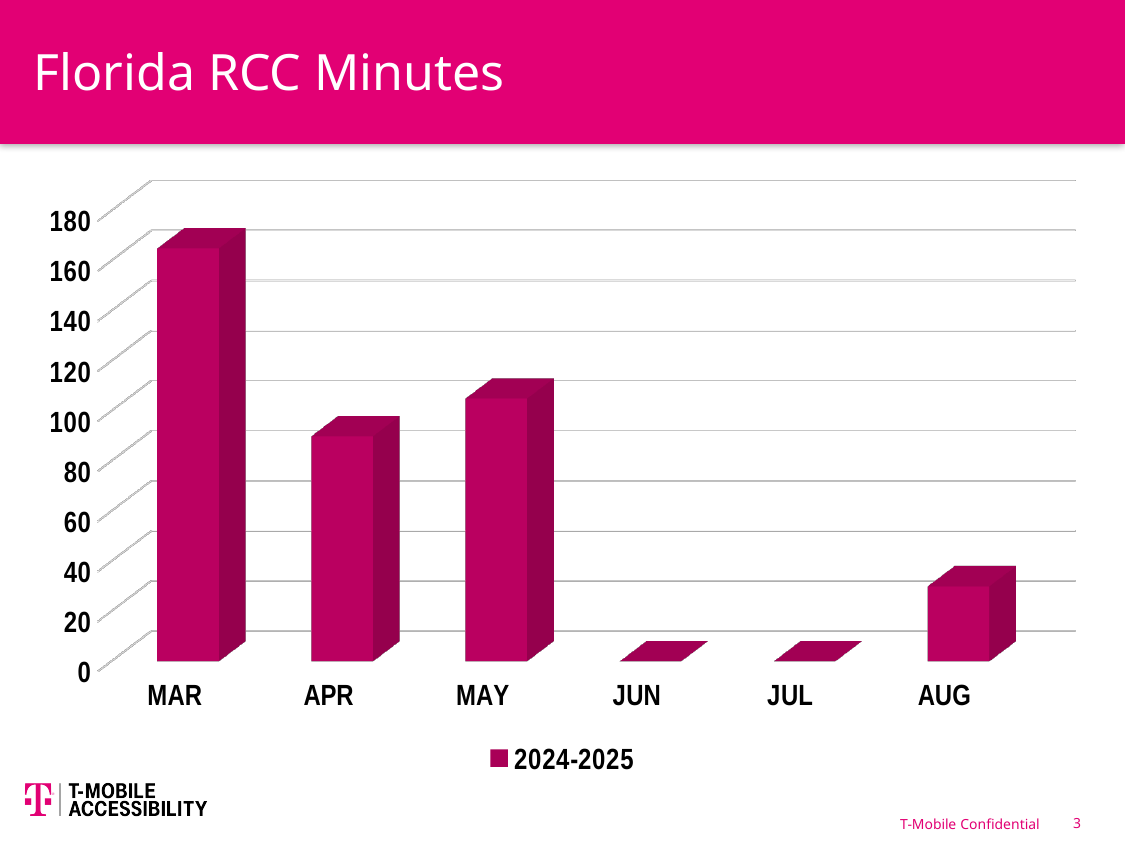
Is the value for MAR greater or less than 140? greater Is the value for APR greater or less than 100? less What series name is shown in the chart legend? 2024-2025 Do the values rise or fall from MAY to JUN? fall Which is larger, the value for MAR or the value for APR? MAR What is the title of the slide containing the chart? Florida RCC Minutes Which is larger, the value for MAY or the value for AUG? MAY How many series does the legend list? 1 How many months are shown on the x axis of the chart? 6 Which month has the highest value in the chart? MAR What kind of chart is shown on the slide? Bar chart Is the value for AUG greater or less than 60? less